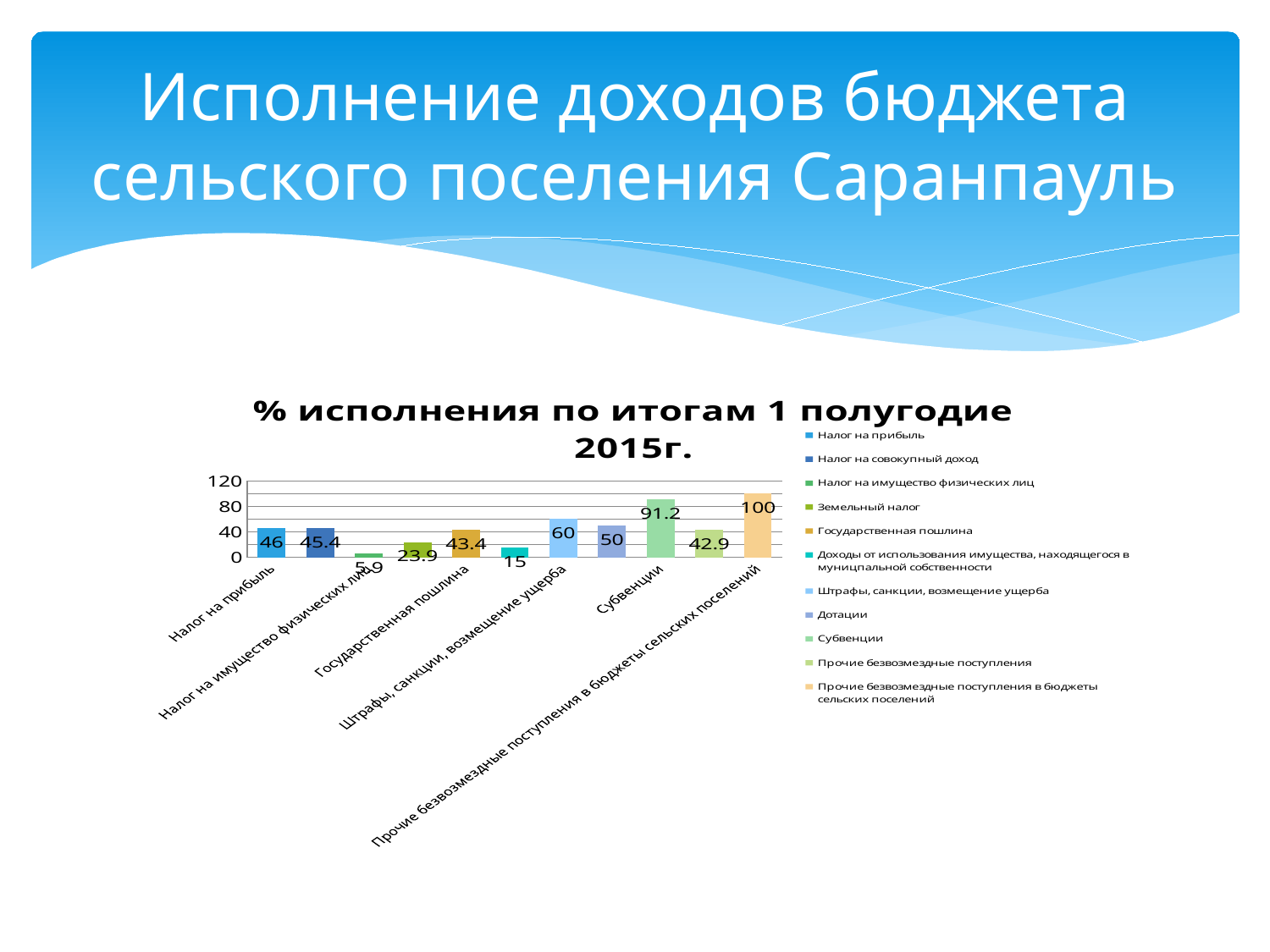
How many entries does the legend list? 11 What is the title of the chart? % исполнения по итогам 1 полугодие 2015г. Is the value for Субвенции greater or less than 80? greater What is the difference between the values for Субвенции and Дотации? 41.2 Which is larger, the value for Штрафы, санкции, возмещение ущерба or the value for Земельный налог? Штрафы, санкции, возмещение ущерба What is the value for Дотации? 50 Which category has the highest value? Прочие безвозмездные поступления в бюджеты сельских поселений Which category has the lowest value? Налог на имущество физических лиц What kind of chart is shown on the slide? Bar chart What is the value for Государственная пошлина? 43.4 What is the value for Налог на прибыль? 46 What is the value for Субвенции? 91.2